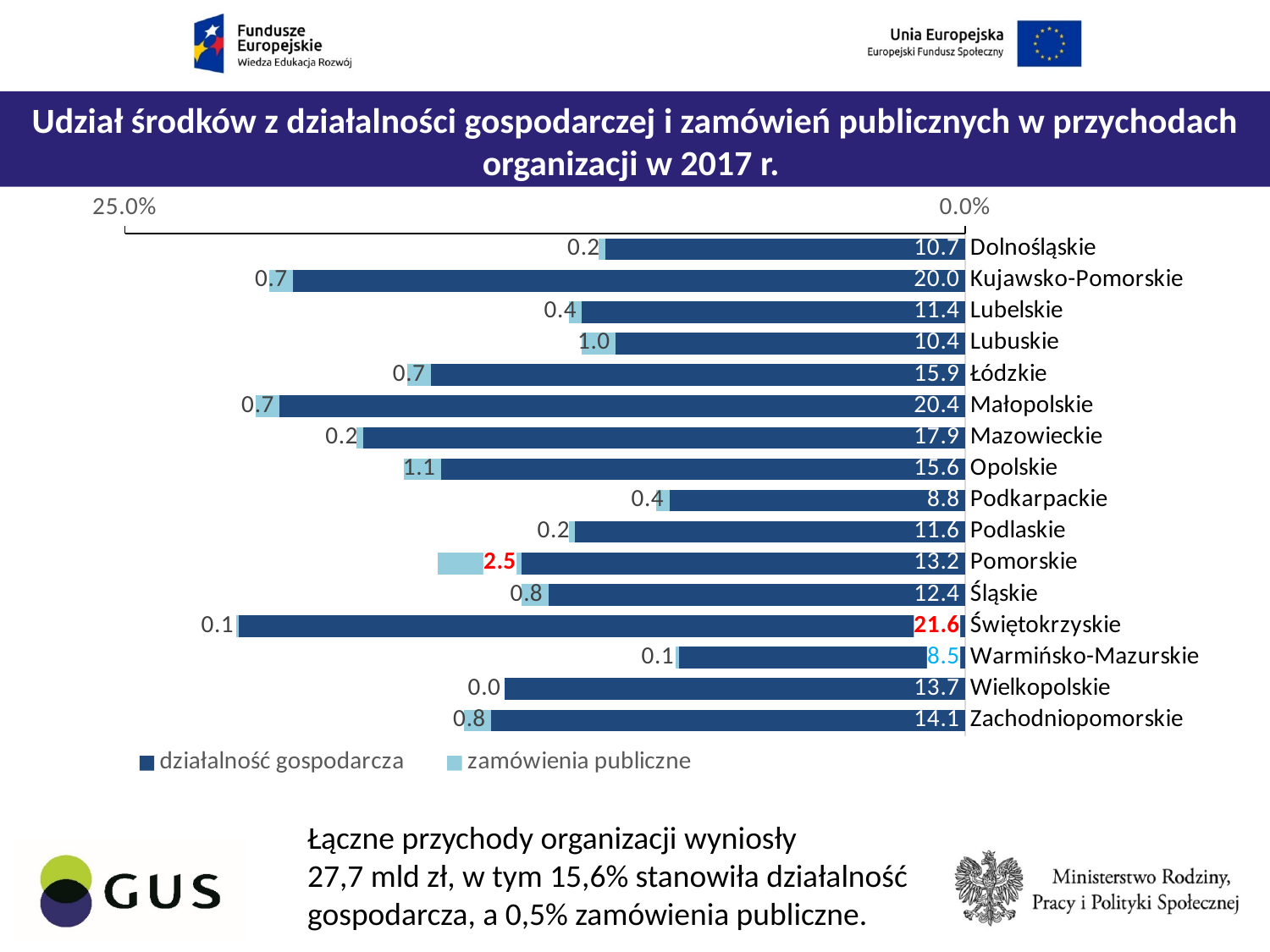
What is the total of the two values for Pomorskie? 15.7 How many voivodeships are shown in the chart? 16 How many series does the legend list? 2 What is the value of zamówienia publiczne for Pomorskie? 2.5 What kind of chart is shown on the slide? Stacked bar chart Which voivodeship has the highest value for zamówienia publiczne? Pomorskie Which voivodeship has the highest value for działalność gospodarcza? Świętokrzyskie What is the value of działalność gospodarcza for Mazowieckie? 17.9 What is the value of działalność gospodarcza for Świętokrzyskie? 21.6 Which voivodeship has the lowest value for działalność gospodarcza? Warmińsko-Mazurskie What is the difference between the działalność gospodarcza values for Mazowieckie and Dolnośląskie? 7.2 Which has a larger działalność gospodarcza value, Kujawsko-Pomorskie or Łódzkie? Kujawsko-Pomorskie